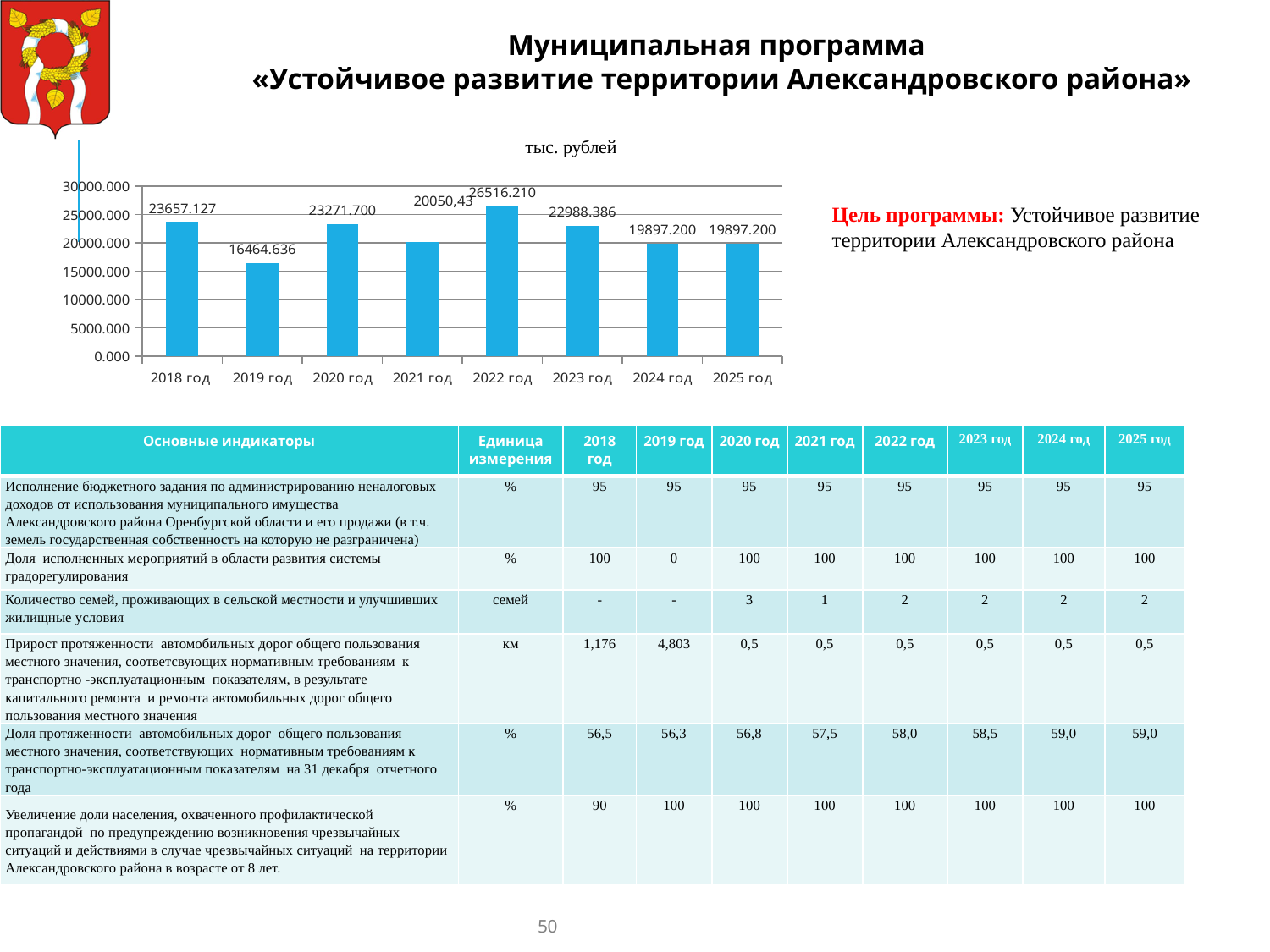
How many years are shown on the bar chart? 8 What is the value for 2025 год on the bar chart? 19897.200 Is the value for 2019 год on the bar chart greater or less than 20000.000? less Which year has the highest value on the bar chart? 2022 год What is the value for 2019 год on the bar chart? 16464.636 Which year has the lowest value on the bar chart? 2019 год What is the value for 2023 год on the bar chart? 22988.386 What kind of chart is shown on the slide? bar chart What is the value for 2018 год on the bar chart? 23657.127 What unit of measurement is stated above the bar chart? тыс. рублей Which is larger on the bar chart, the value for 2018 год or the value for 2023 год? 2018 год What is the difference between the values for 2022 год and 2019 год on the bar chart? 10051.574